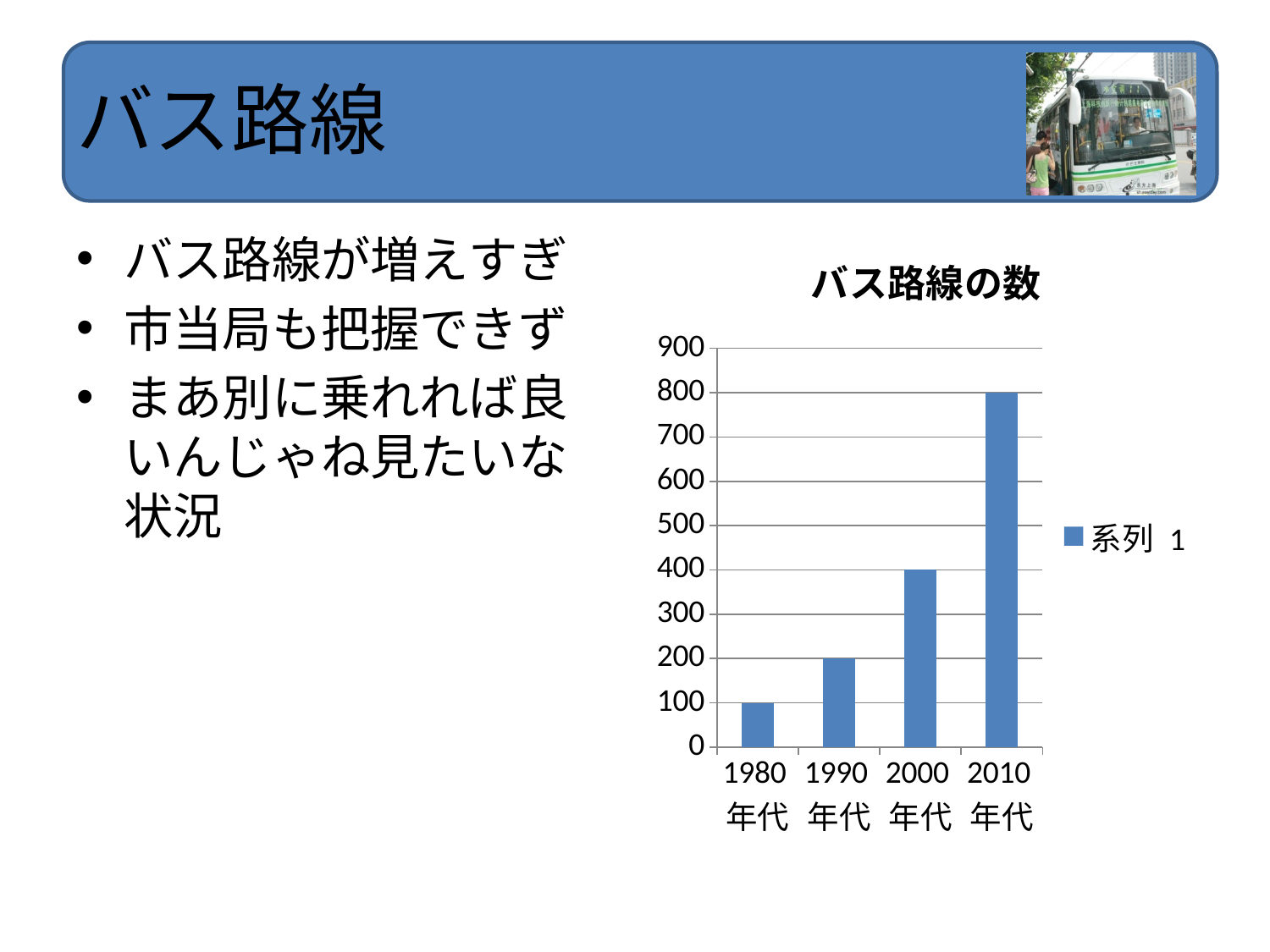
What is the value for 2010年代? 800 What is the difference between the values for 2010年代 and 2000年代? 400 Do the values rise or fall from 1980年代 to 2010年代? rise How many categories are shown on the x axis of the chart? 4 What is the value for 2000年代? 400 What is the value for 1980年代? 100 Which category has the highest value? 2010年代 How many series does the legend list? 1 What kind of chart is shown on the slide? bar chart What is the title of the chart? バス路線の数 Which category has the lowest value? 1980年代 What is the value for 1990年代? 200